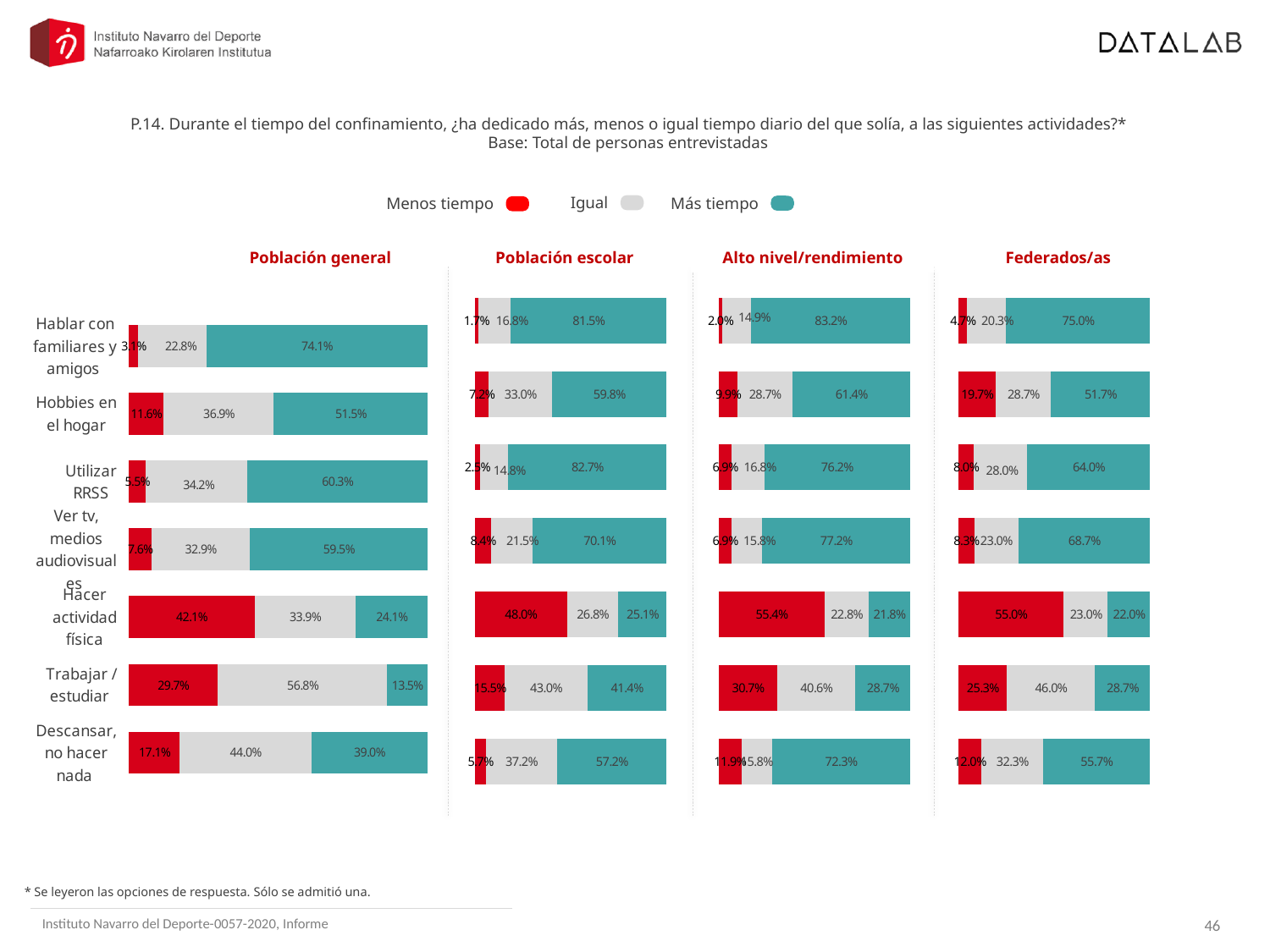
How many series does the legend list? 3 How many activities (categories) are shown in each chart? 7 In the Población general chart, which activity has the highest Más tiempo percentage? Hablar con familiares y amigos In the Población general chart, what is the Menos tiempo value for Hacer actividad física? 42.1% In the Población general chart, what percentage of people dedicated more time (Más tiempo) to Hablar con familiares y amigos? 74.1% In the Alto nivel/rendimiento chart, what is the Más tiempo value for Descansar, no hacer nada? 72.3% In the Alto nivel/rendimiento chart, what is the difference between the Menos tiempo value for Hacer actividad física and the Menos tiempo value for Trabajar / estudiar? 24.7 percentage points In the Federados/as chart, what is the Menos tiempo value for Hobbies en el hogar? 19.7% What type of chart is used on this slide? Stacked bar chart In the Población escolar chart, which activity has the lowest Más tiempo percentage? Hacer actividad física In the Población escolar chart, what is the Igual value for Trabajar / estudiar? 43.0% In the Federados/as chart, which is larger for Trabajar / estudiar: the Igual value or the Más tiempo value? Igual